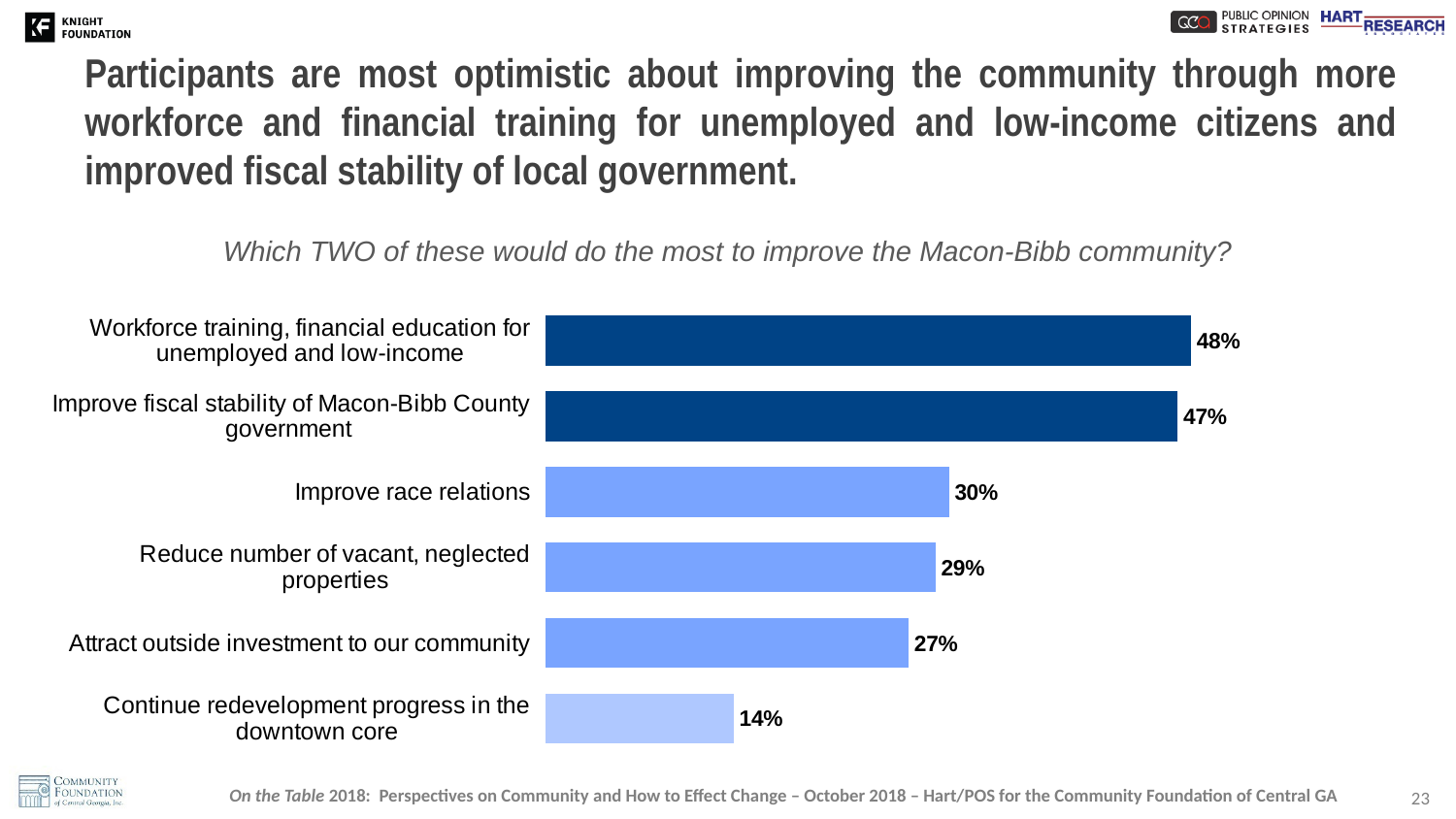
What kind of chart is shown on the slide? Bar chart What percentage is shown for 'Attract outside investment to our community'? 27% What question is the chart based on, as shown above the chart? Which TWO of these would do the most to improve the Macon-Bibb community? Which category has the lowest value? Continue redevelopment progress in the downtown core How many categories are shown in the chart? 6 What is the difference between 'Workforce training, financial education for unemployed and low-income' and 'Improve fiscal stability of Macon-Bibb County government'? 1% How many bars are shown in the darker blue colour? 2 Which category has the highest value? Workforce training, financial education for unemployed and low-income What percentage of participants chose 'Improve race relations'? 30% What is the difference between 'Improve race relations' and 'Continue redevelopment progress in the downtown core'? 16% Which is larger: the value for 'Reduce number of vacant, neglected properties' or 'Attract outside investment to our community'? Reduce number of vacant, neglected properties What is the value for 'Continue redevelopment progress in the downtown core'? 14%